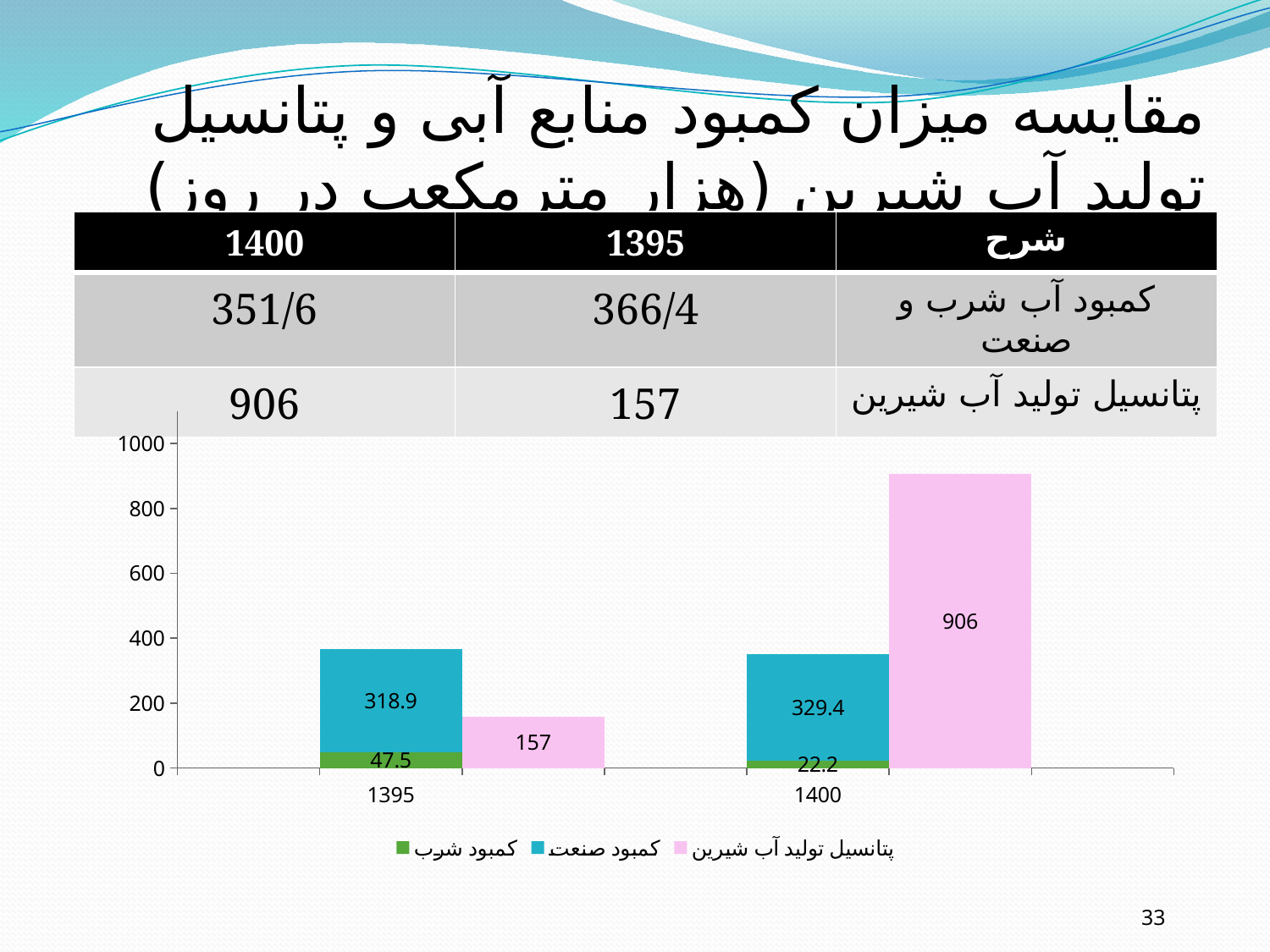
What is the difference between the پتانسیل تولید آب شیرین values for 1400 and 1395? 749 How many categories are shown on the x axis of the chart? 2 Which series is shown in pink in the chart? پتانسیل تولید آب شیرین Is the value of پتانسیل تولید آب شیرین for 1400 greater or less than 800? greater What is the value of پتانسیل تولید آب شیرین for 1400 in the chart? 906 What is the value of کمبود صنعت for 1395 in the chart? 318.9 Which year has the higher value for کمبود شرب, 1395 or 1400? 1395 What is the total of the stacked bar (کمبود شرب plus کمبود صنعت) for 1395? 366.4 How many series does the chart legend list? 3 What type of chart is shown on the slide? bar chart What is the value of کمبود شرب for 1400 in the chart? 22.2 What is the value of پتانسیل تولید آب شیرین for 1395 in the chart? 157